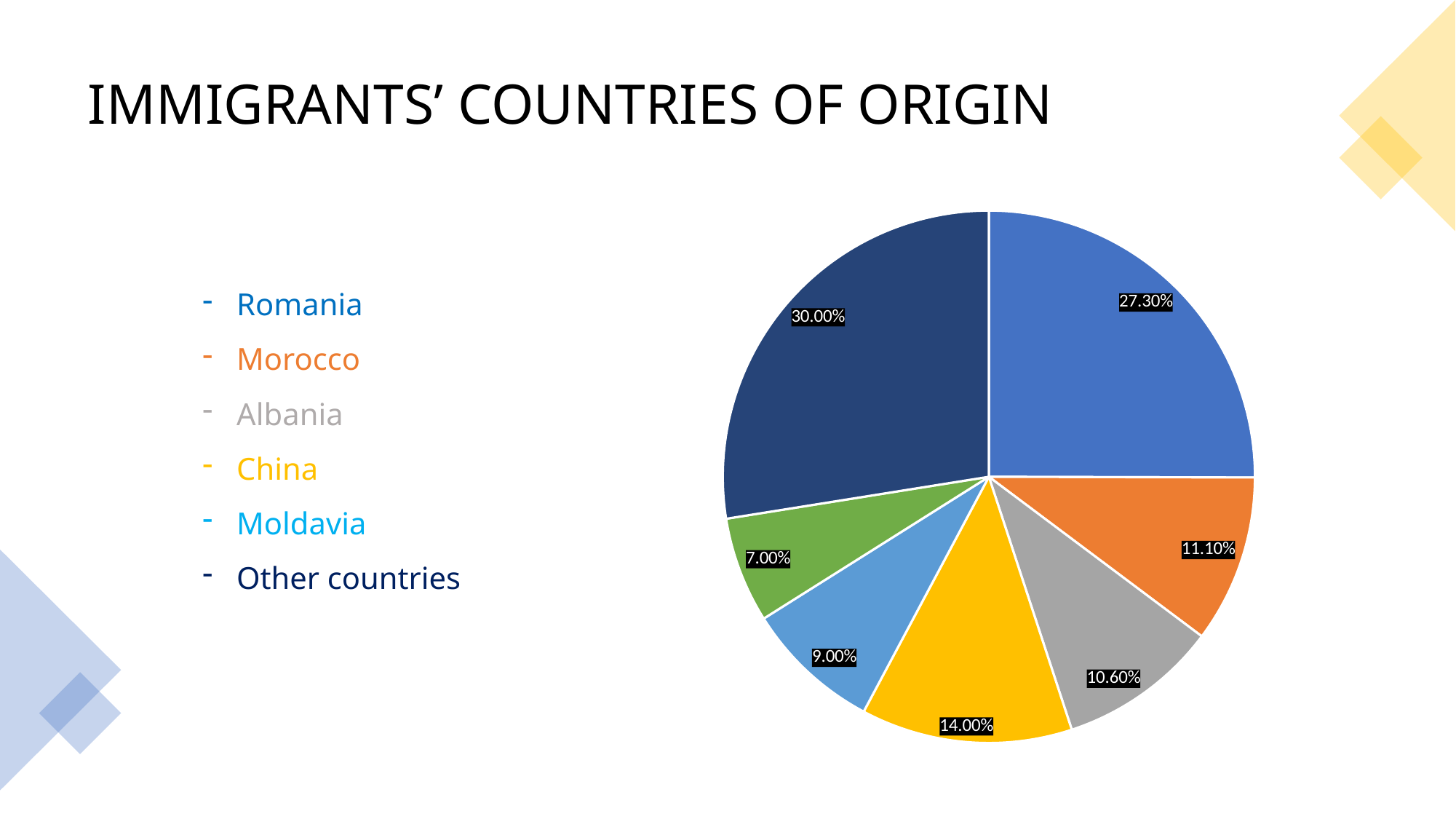
What is the smallest percentage labelled on the pie chart? 7.00% What is the title of the slide containing the pie chart? IMMIGRANTS' COUNTRIES OF ORIGIN How many slices does the pie chart have? 7 What percentage is shown for Morocco? 11.10% What is the difference between the percentages for Romania and Morocco? 16.20% Which category has the largest slice of the pie? Other countries Which has the larger share, Albania or Moldavia? Albania What is the difference between the percentages for Other countries and Romania? 2.70% What percentage of the pie does Romania account for? 27.30% What kind of chart is shown on the slide? pie chart